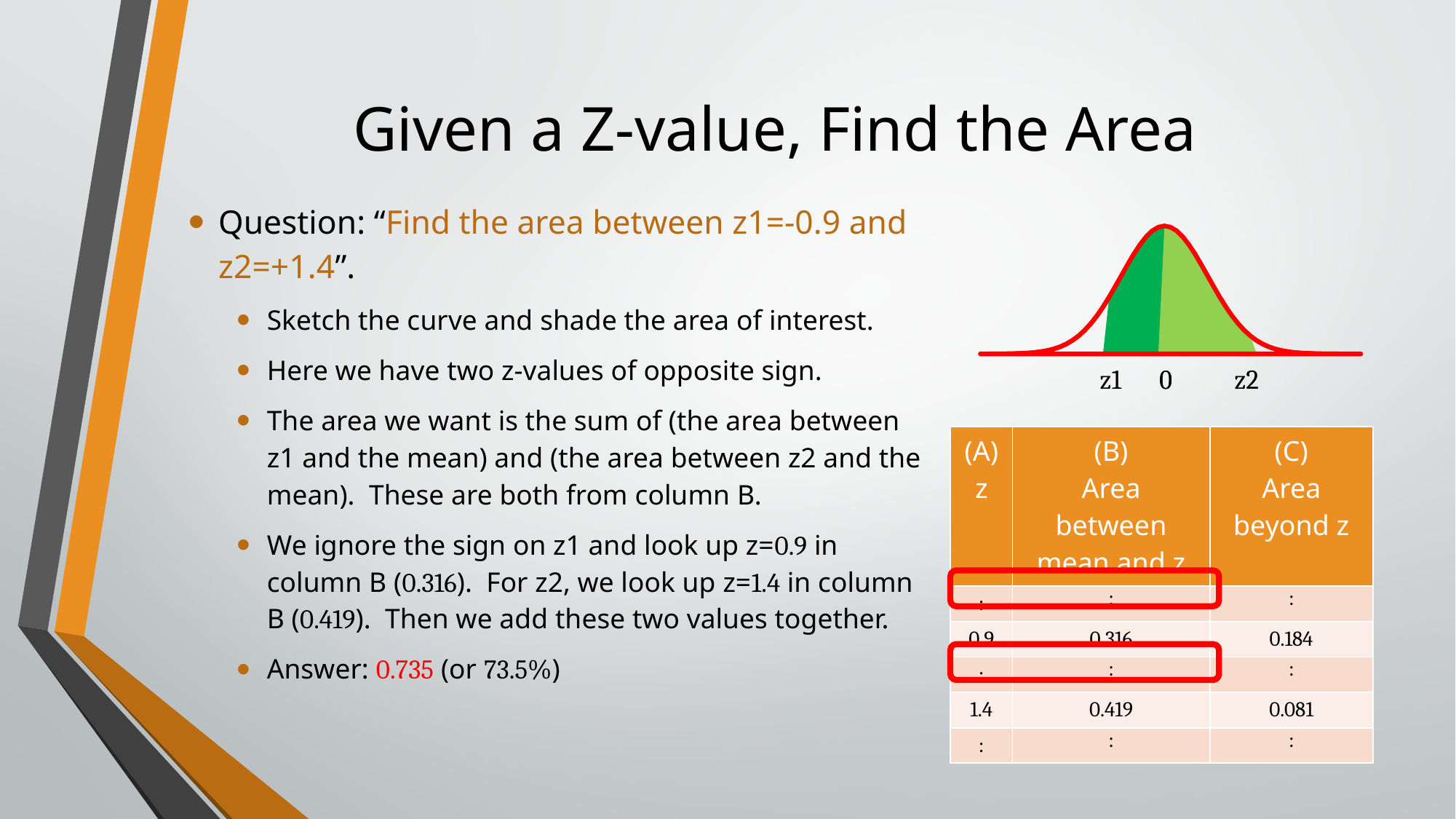
How many shaded regions are there under the curve at the top right? 2 What labels appear along the horizontal axis of the curve at the top right? z1, 0, z2 On the curve at the top right, which shaded region is the darker green: the one between z1 and 0 or the one between 0 and z2? The one between z1 and 0 How many labels are shown along the horizontal axis of the curve at the top right? 3 On the curve at the top right, is z2 to the left or to the right of 0? right What kind of chart is shown at the top right of the slide? A normal distribution (bell) curve On the curve at the top right, is z1 to the left or to the right of 0? left